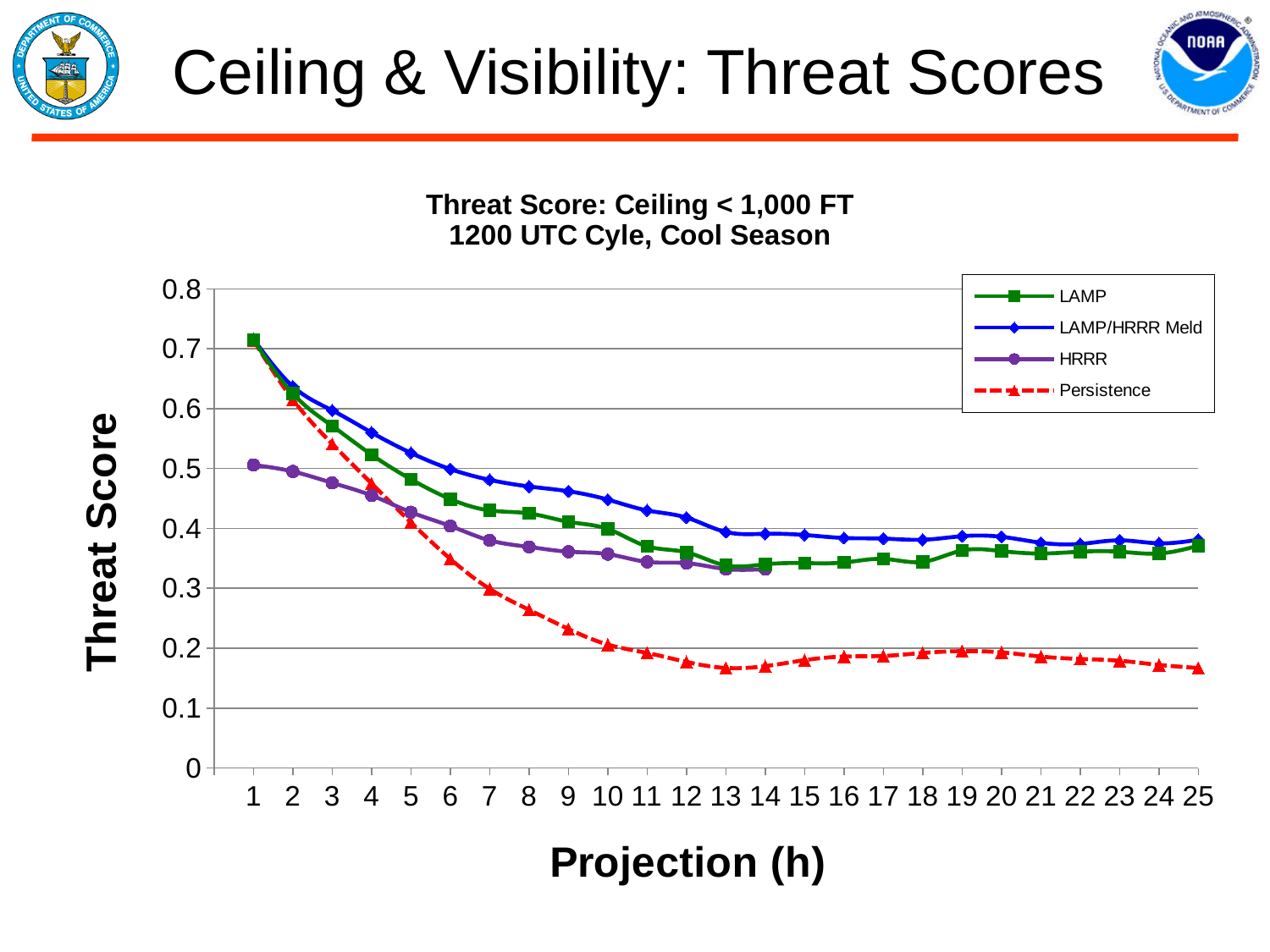
Which series has the lowest threat score at projection 20? Persistence How many projection hours are plotted along the x axis? 25 Which legend entry is drawn with a dashed red line? Persistence At projection 25, which is larger: the LAMP/HRRR Meld value or the Persistence value? LAMP/HRRR Meld Is the LAMP value at projection 6 greater or less than 0.4? greater How many series does the legend list? 4 Does the Persistence threat score rise or fall from projection 1 to projection 13? fall Is the HRRR value at projection 1 greater or less than 0.6? less Is the Persistence value at projection 13 greater or less than 0.2? less What kind of chart is shown on the slide? line chart Which series has the highest threat score at projection 10? LAMP/HRRR Meld